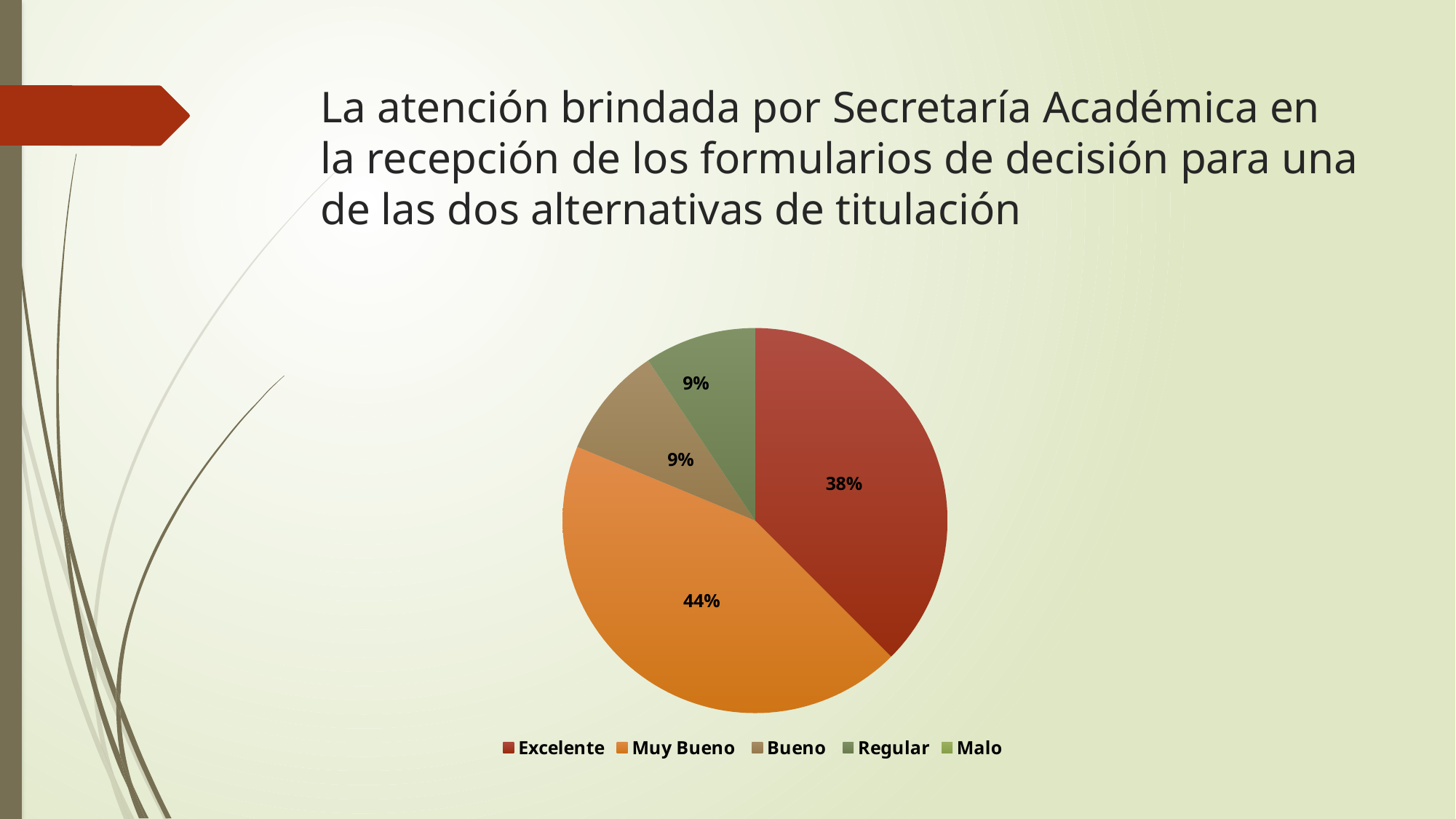
Which category has the largest slice of the pie? Muy Bueno What kind of chart is shown on the slide? pie chart What is the combined share of the Excelente and Muy Bueno slices? 82% Which is larger, the Excelente slice or the Muy Bueno slice? Muy Bueno How many categories does the legend list? 5 What share of the pie does the Regular slice represent? 9% What share of the pie does the Bueno slice represent? 9% What is the difference in percentage points between the Muy Bueno slice and the Excelente slice? 6 Which legend entry is shown in orange? Muy Bueno What share of the pie does the Excelente slice represent? 38% What is the difference in percentage points between the Excelente slice and the Bueno slice? 29 What share of the pie does the Muy Bueno slice represent? 44%